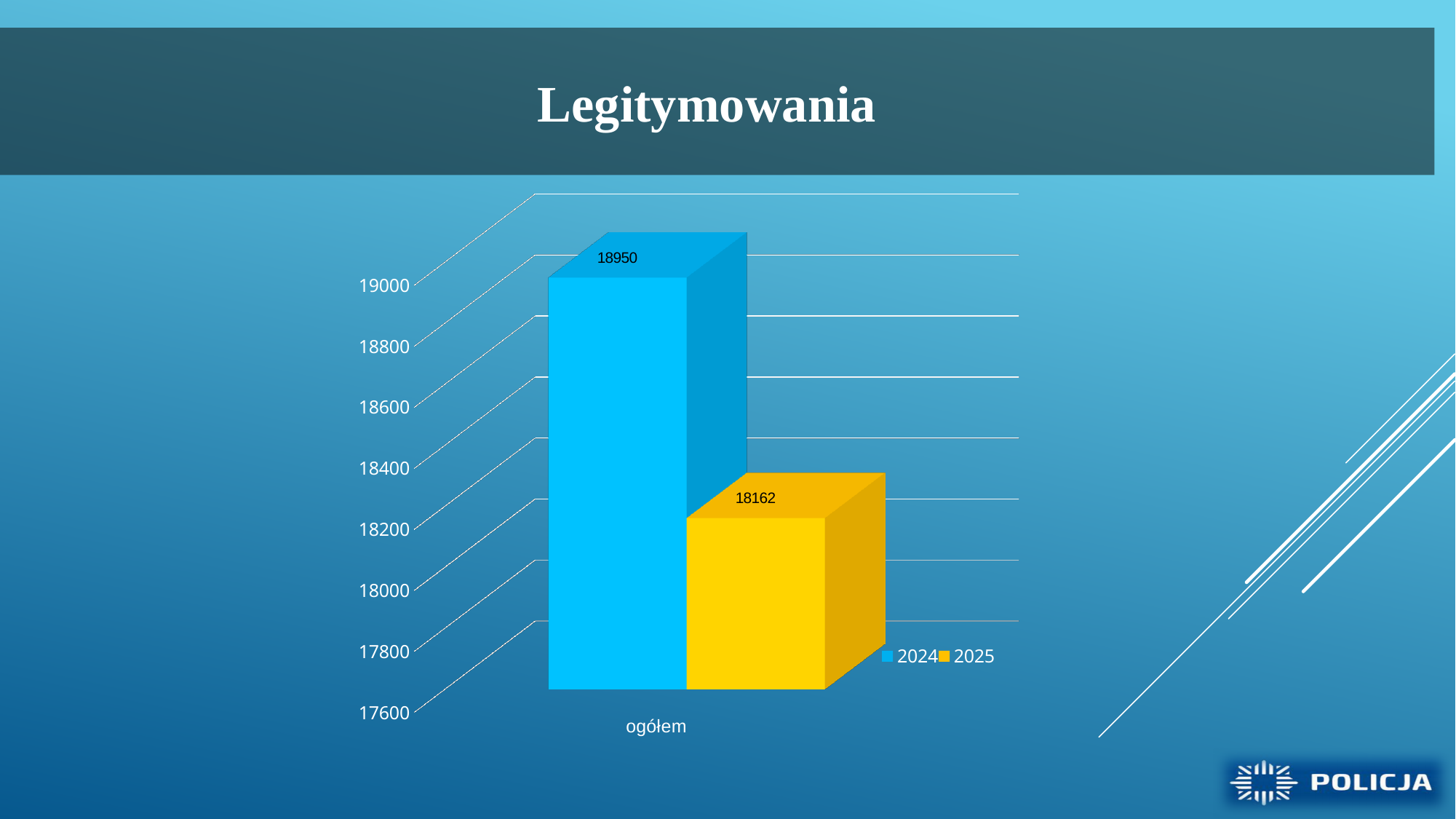
How many series does the legend list? 2 Is the value for 2025 greater or less than 18400? less What is the value for 2024 in the ogółem category? 18950 Is the value for 2024 greater or less than 18800? greater What is the label of the category on the x axis? ogółem Which series has the higher value for ogółem, 2024 or 2025? 2024 What kind of chart is shown on the slide? bar chart What is the value for 2025 in the ogółem category? 18162 What is the title of the slide? Legitymowania How many categories are shown on the x axis? 1 What is the difference between the 2024 and 2025 values for ogółem? 788 Which colour represents the 2025 series? yellow